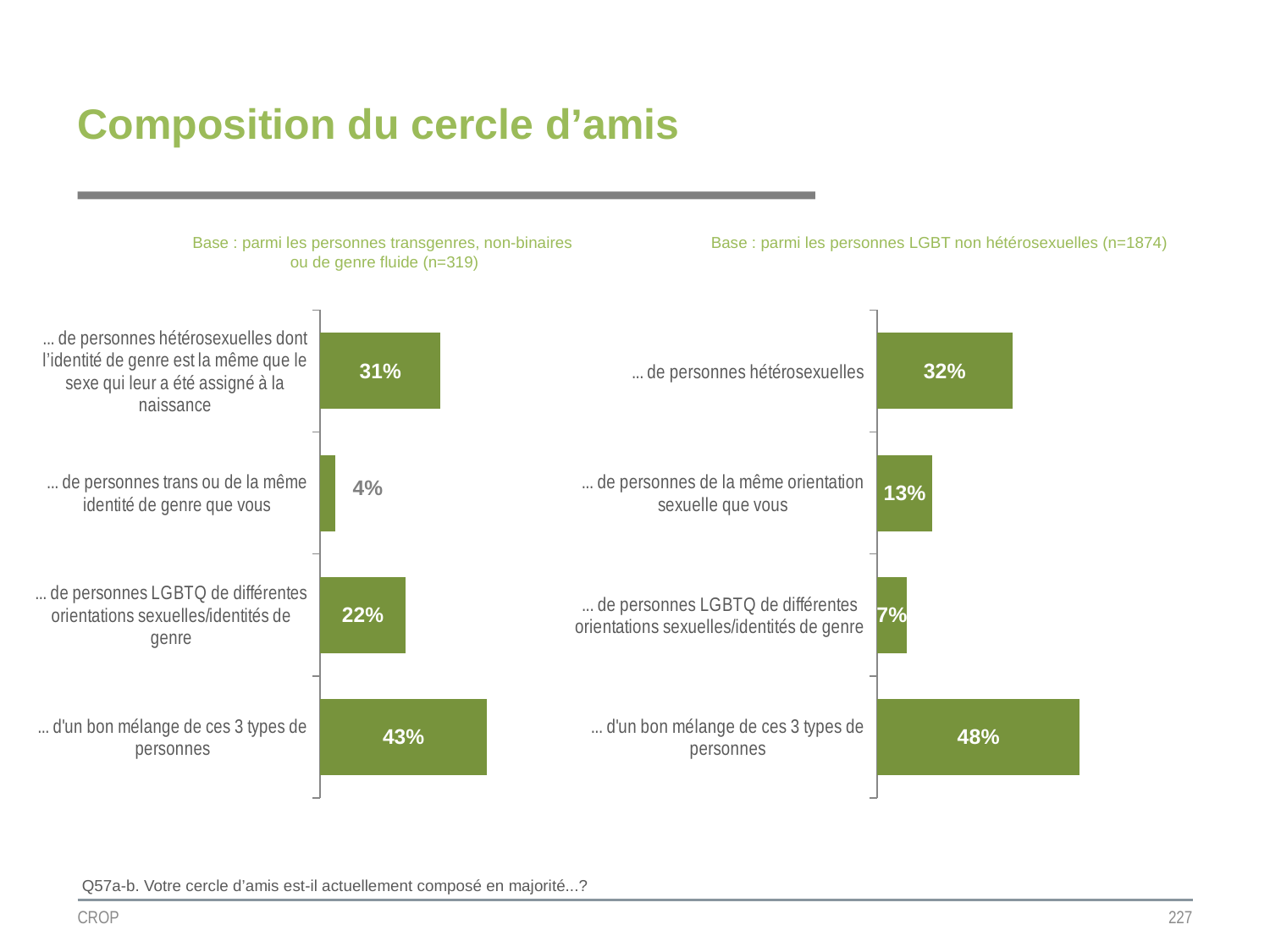
In the left chart (Base : parmi les personnes transgenres, non-binaires ou de genre fluide), what is the value for '... d'un bon mélange de ces 3 types de personnes'? 43% What type of chart is the left chart (Base : parmi les personnes transgenres, non-binaires ou de genre fluide)? Bar chart How many categories does the right chart (Base : parmi les personnes LGBT non hétérosexuelles) show? 4 In the left chart (Base : parmi les personnes transgenres, non-binaires ou de genre fluide), which category has the highest value? ... d'un bon mélange de ces 3 types de personnes In the left chart (Base : parmi les personnes transgenres, non-binaires ou de genre fluide), what is the difference between the values for '... d'un bon mélange de ces 3 types de personnes' and '... de personnes LGBTQ de différentes orientations sexuelles/identités de genre'? 21% In the right chart (Base : parmi les personnes LGBT non hétérosexuelles), what is the value for '... de personnes hétérosexuelles'? 32% In the left chart (Base : parmi les personnes transgenres, non-binaires ou de genre fluide), what is the value for '... de personnes trans ou de la même identité de genre que vous'? 4% What is the sample size (n) stated for the right chart's base? n=1874 In the right chart (Base : parmi les personnes LGBT non hétérosexuelles), what is the difference between the values for '... de personnes hétérosexuelles' and '... de personnes de la même orientation sexuelle que vous'? 19% Which is larger: the value for '... d'un bon mélange de ces 3 types de personnes' in the left chart or in the right chart? The right chart (48%) In the right chart (Base : parmi les personnes LGBT non hétérosexuelles), which category has the lowest value? ... de personnes LGBTQ de différentes orientations sexuelles/identités de genre In the right chart (Base : parmi les personnes LGBT non hétérosexuelles), what is the value for '... de personnes LGBTQ de différentes orientations sexuelles/identités de genre'? 7%